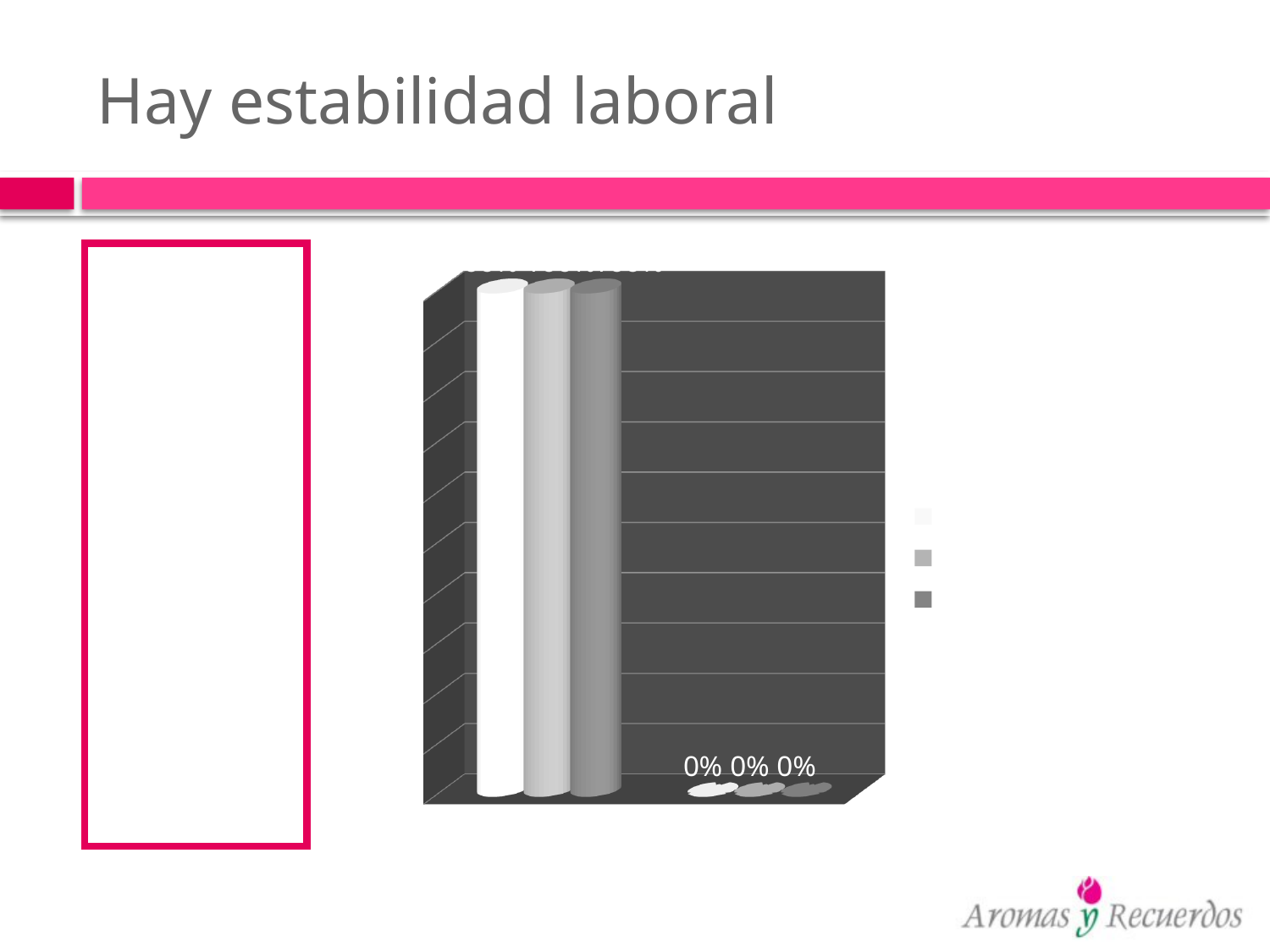
What is the background colour of the chart's plot area? dark grey What colour is the leftmost bar in the left-hand group? white How many groups of bars are plotted on the chart? 2 What value is printed on the data labels for the right-hand group of bars? 0% Which group of bars is taller, the left-hand group or the right-hand group? left-hand group What kind of chart is shown on the slide? bar chart How many bars in the right-hand group are labelled 0%? 3 Do the bar heights rise or fall from the left-hand group to the right-hand group? fall How many series does the chart's legend list? 3